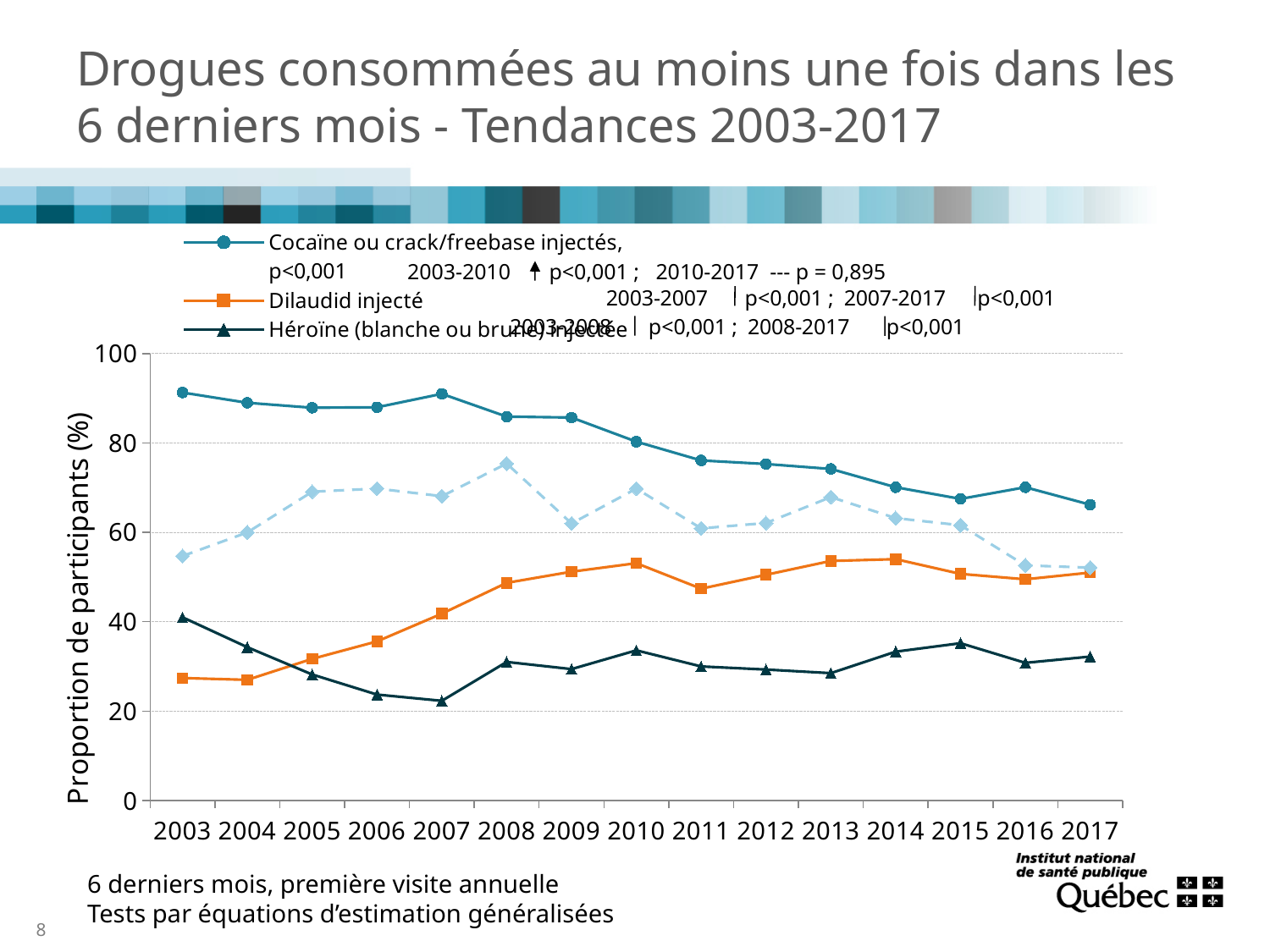
Is the value for Héroïne (blanche ou brune) injectée in 2010 greater or less than 40? less Is the value for Cocaïne ou crack/freebase injectés in 2003 greater or less than 80? greater Is the value for Cocaïne ou crack/freebase injectés in 2017 greater or less than 80? less In 2003, which is larger: Dilaudid injecté or Héroïne (blanche ou brune) injectée? Héroïne (blanche ou brune) injectée What is the label of the y axis? Proportion de participants (%) Does the Dilaudid injecté series rise or fall from 2003 to 2017? rise What kind of chart is shown on the slide? line chart How many years are plotted along the x axis? 15 How many series does the chart legend list? 3 Does the Cocaïne ou crack/freebase injectés series rise or fall from 2003 to 2017? fall